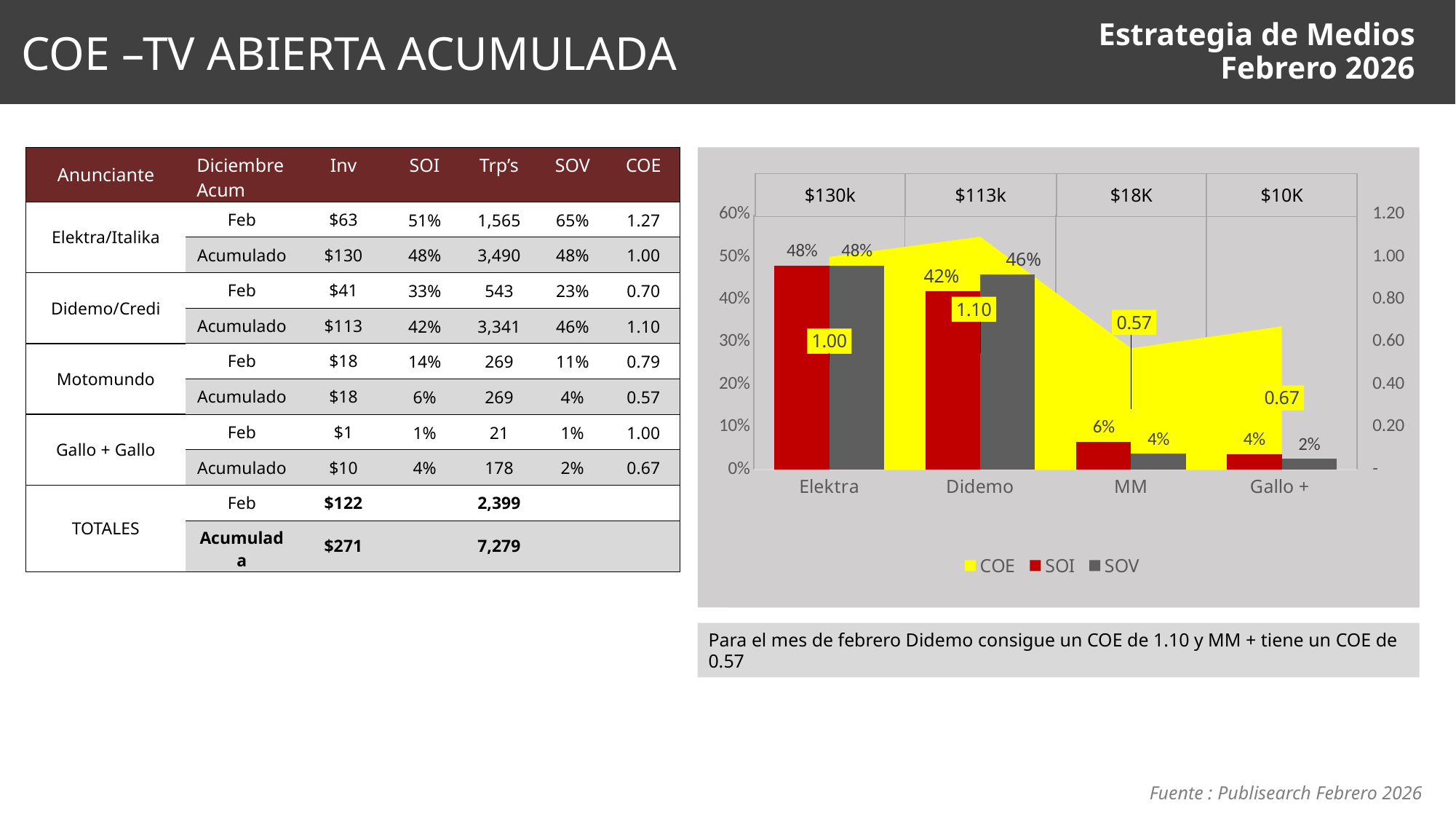
Which series is drawn in yellow? COE Does the SOI value rise or fall from Elektra to Gallo + along the x axis? Falls Which category has the highest COE value? Didemo What is the SOI value for Didemo? 42% What is the COE value for MM? 0.57 Which is larger, the SOI value for Elektra or the SOI value for Didemo? Elektra How many categories are shown on the x axis? 4 What investment figure is shown above the Didemo bars? $113k How many series does the legend list? 3 What is the difference between the SOV and SOI values for Didemo? 4 percentage points What is the SOV value for Gallo +? 2% Which category has the lowest SOV value? Gallo +